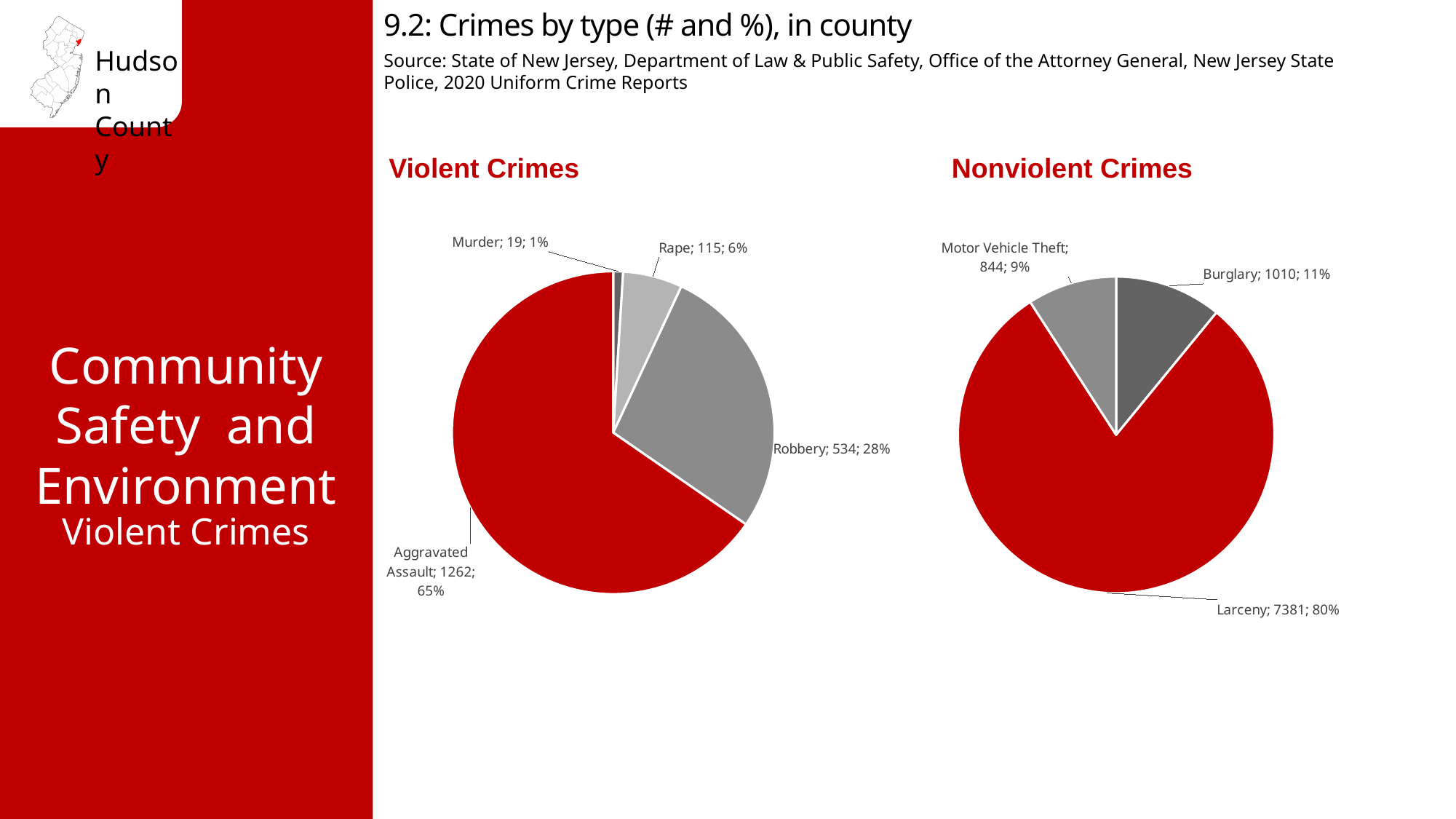
In the Violent Crimes pie chart, how many categories are shown? 4 In the Violent Crimes pie chart, which category has the smallest slice? Murder In the Nonviolent Crimes pie chart, which is larger, Burglary or Motor Vehicle Theft? Burglary In the Nonviolent Crimes pie chart, how many categories are shown? 3 In the Violent Crimes pie chart, how many Aggravated Assault crimes are shown? 1262 In the Violent Crimes pie chart, what is the difference between the Robbery count and the Rape count? 419 In the Violent Crimes pie chart, which category has the largest slice? Aggravated Assault What type of chart is used for the Nonviolent Crimes data? Pie chart In the Nonviolent Crimes pie chart, what is the difference between the Burglary count and the Motor Vehicle Theft count? 166 In the Nonviolent Crimes pie chart, what percentage share does Motor Vehicle Theft have? 9% In the Violent Crimes pie chart, what percentage share does Robbery have? 28% In the Nonviolent Crimes pie chart, how many Larceny crimes are shown? 7381